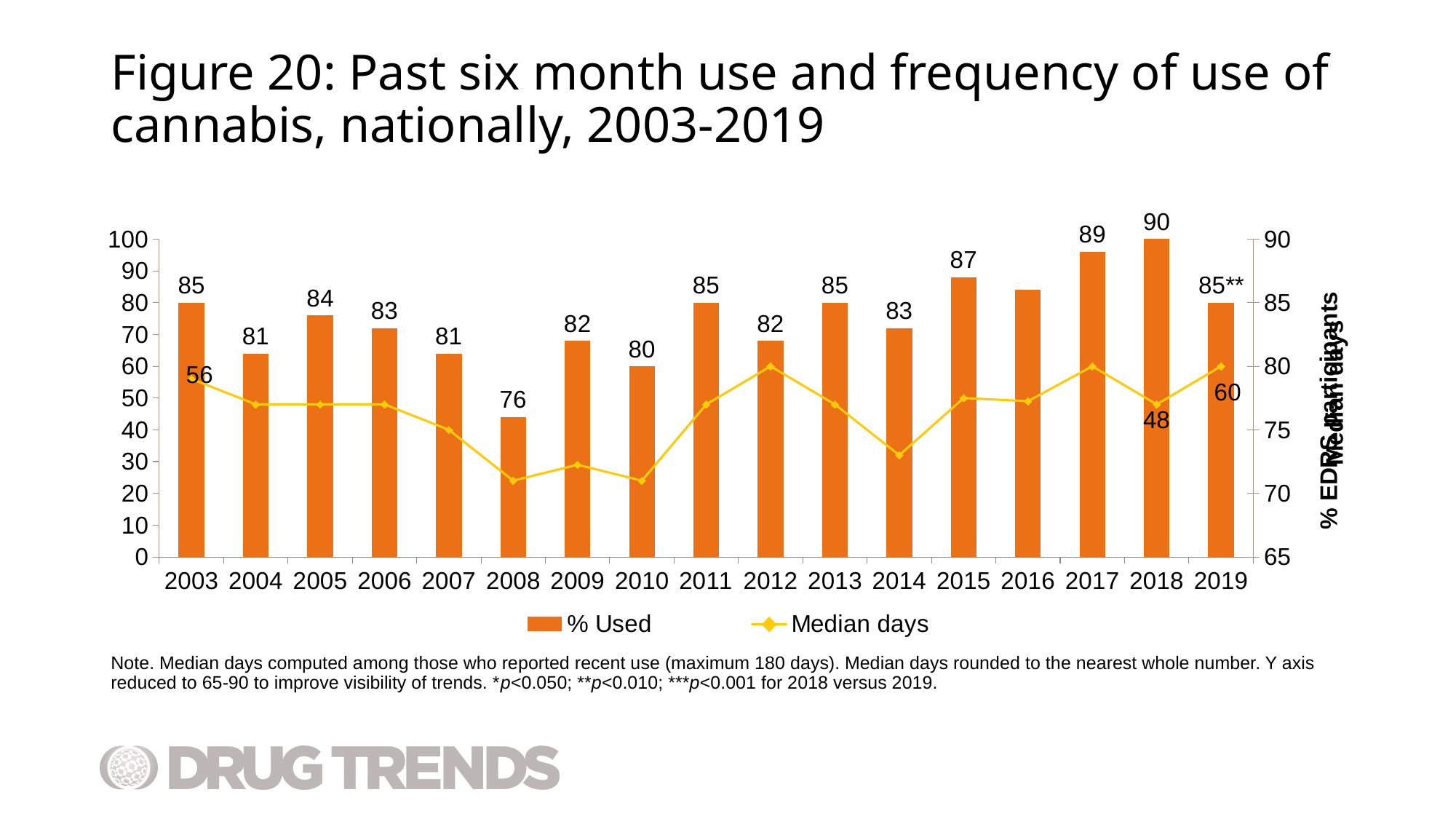
What is the difference between the Median days values for 2019 and 2018? 12 What is the % Used value for 2008? 76 How many years are shown on the x axis? 17 Is the Median days value for 2008 greater or less than 30? less Which year has the highest % Used value? 2018 Which year has a higher % Used value, 2015 or 2016? 2015 What is the % Used value for 2018? 90 What is the Median days value labelled for 2019? 60 Which year has the lowest % Used value? 2008 How many series does the legend list? 2 What is the Median days value labelled for 2003? 56 What is the difference between the % Used values for 2018 and 2008? 14